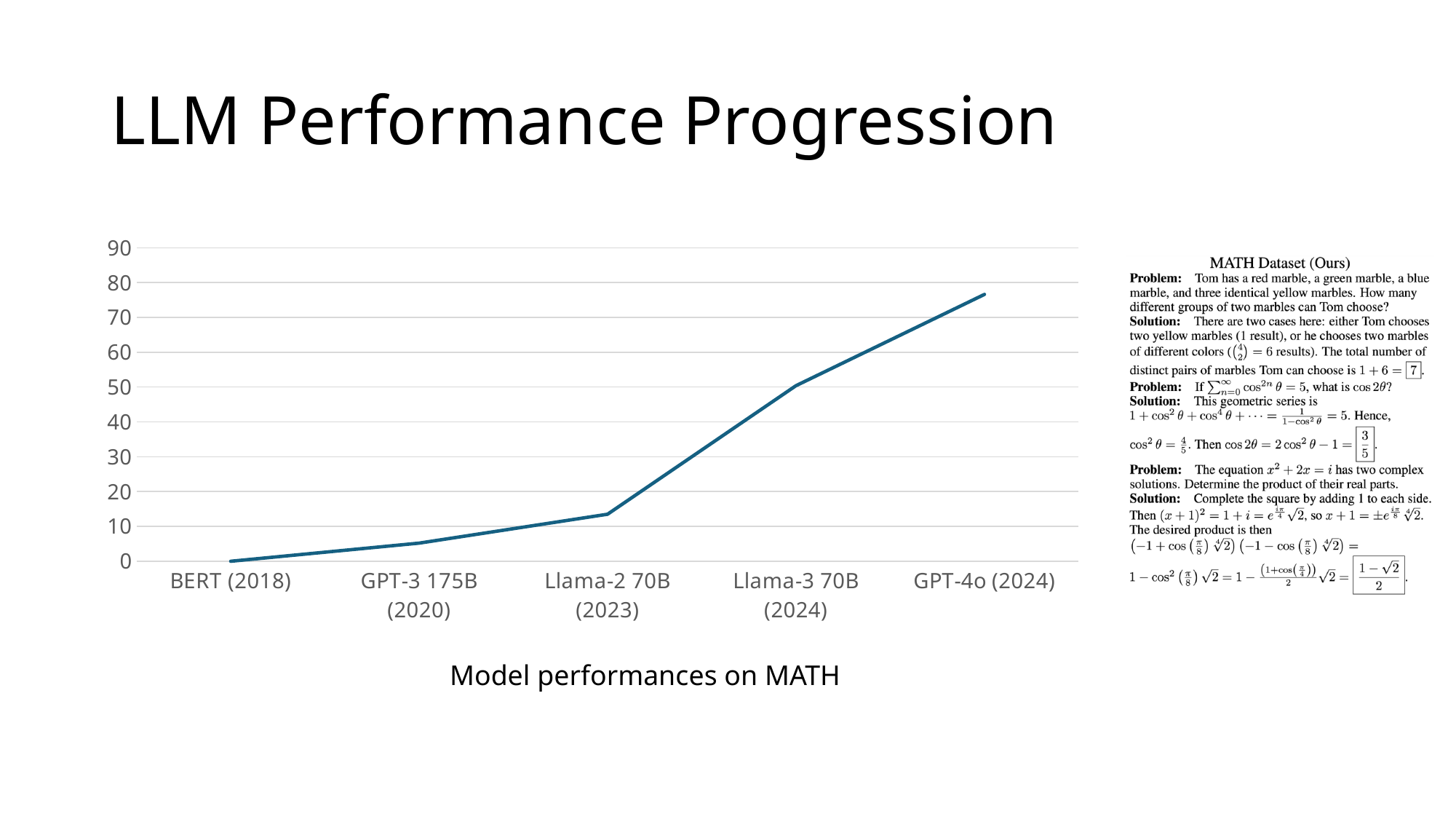
Which model has the lowest value in the chart? BERT (2018) What kind of chart is shown on the slide? line chart Is the value for Llama-3 70B (2024) greater or less than 40? greater Do the values rise or fall from left to right along the x axis? rise Which model has the highest value in the chart? GPT-4o (2024) Which has a larger value, Llama-3 70B (2024) or Llama-2 70B (2023)? Llama-3 70B (2024) How many models are plotted on the x axis of the chart? 5 What is the highest value shown on the chart's y axis? 90 Is the value for Llama-2 70B (2023) greater or less than 20? less Is the value for GPT-3 175B (2020) greater or less than 10? less What is the caption below the chart? Model performances on MATH